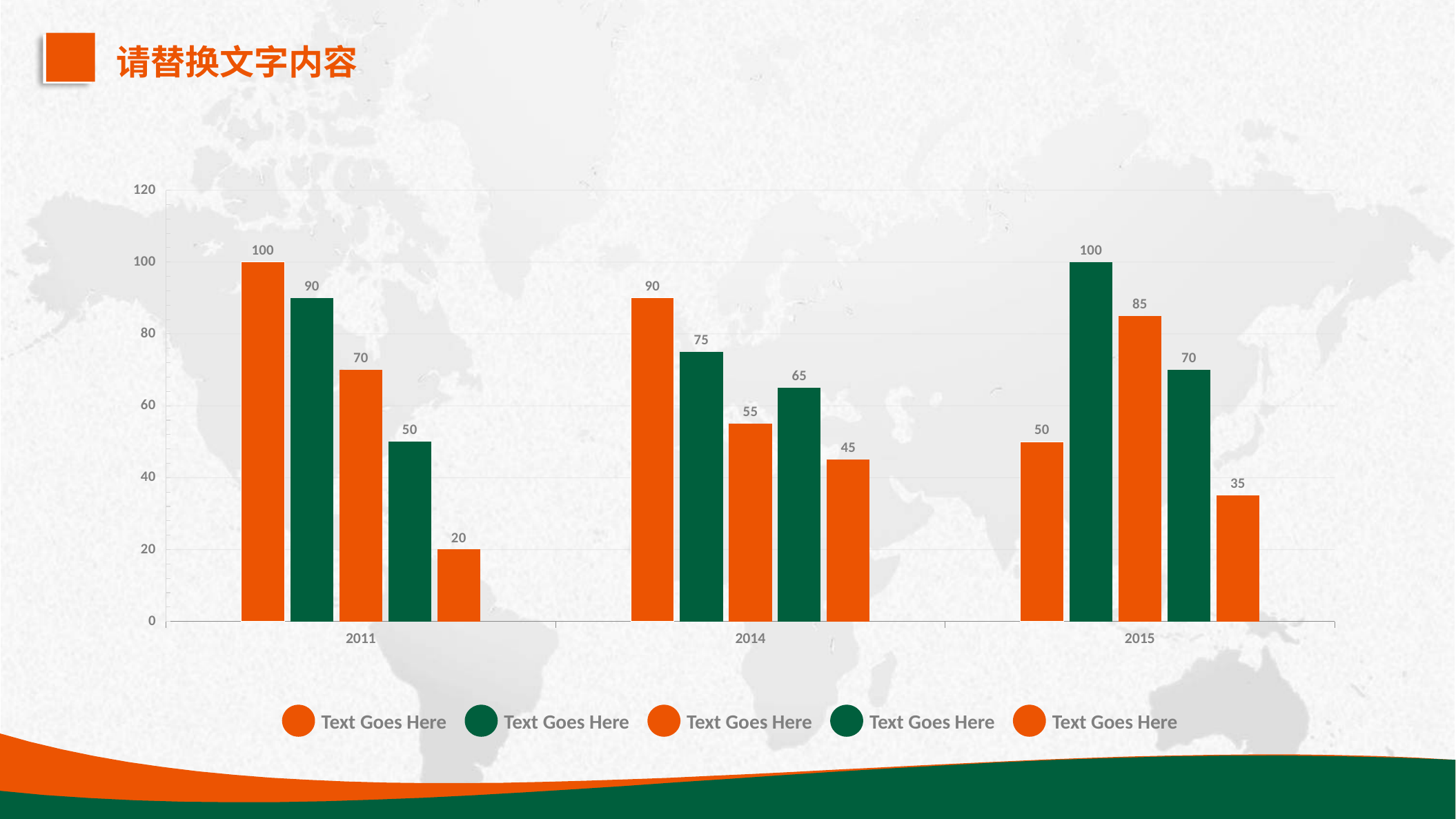
Which bar in the 2015 group has the lowest value? the last (rightmost) bar, 35 How many categories are shown on the x axis? 3 What is the value of the first (leftmost) bar in the 2011 group? 100 What kind of chart is shown on the slide? bar chart What is the value of the second bar in the 2015 group? 100 What is the value of the last (rightmost) bar in the 2011 group? 20 Which bar in the 2014 group has the highest value? the first (leftmost) bar, 90 Which is larger: the fourth bar in the 2014 group or the fourth bar in the 2015 group? the fourth bar in the 2015 group (70) Does the value of the first (leftmost) bar rise or fall from 2011 to 2015? fall What is the difference between the first bar in the 2011 group (100) and the first bar in the 2015 group (50)? 50 How many series does the legend list? 5 What is the value of the third bar in the 2014 group? 55